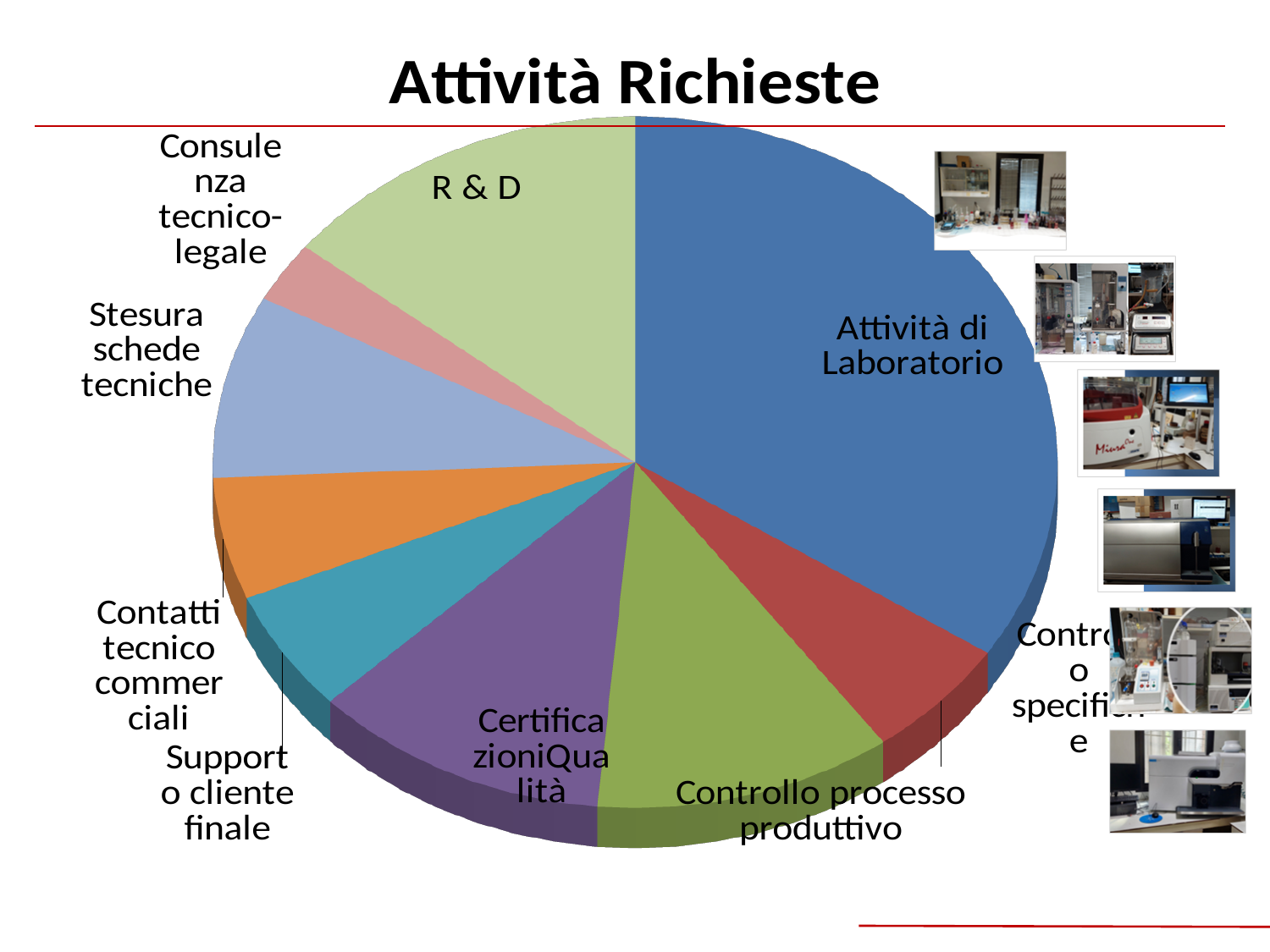
Which slice is larger, Stesura schede tecniche or Contatti tecnico commerciali? Stesura schede tecniche Which activity has the smallest slice of the pie? Consulenza tecnico-legale Which activity has the largest slice of the pie? Attività di Laboratorio How many slices does the pie chart have? 9 Which slice is larger, Certificazioni Qualità or Supporto cliente finale? Certificazioni Qualità What is the title of the chart? Attività Richieste What colour is the slice for Attività di Laboratorio? blue Which slice is larger, Attività di Laboratorio or R & D? Attività di Laboratorio What kind of chart is shown on the slide? pie chart